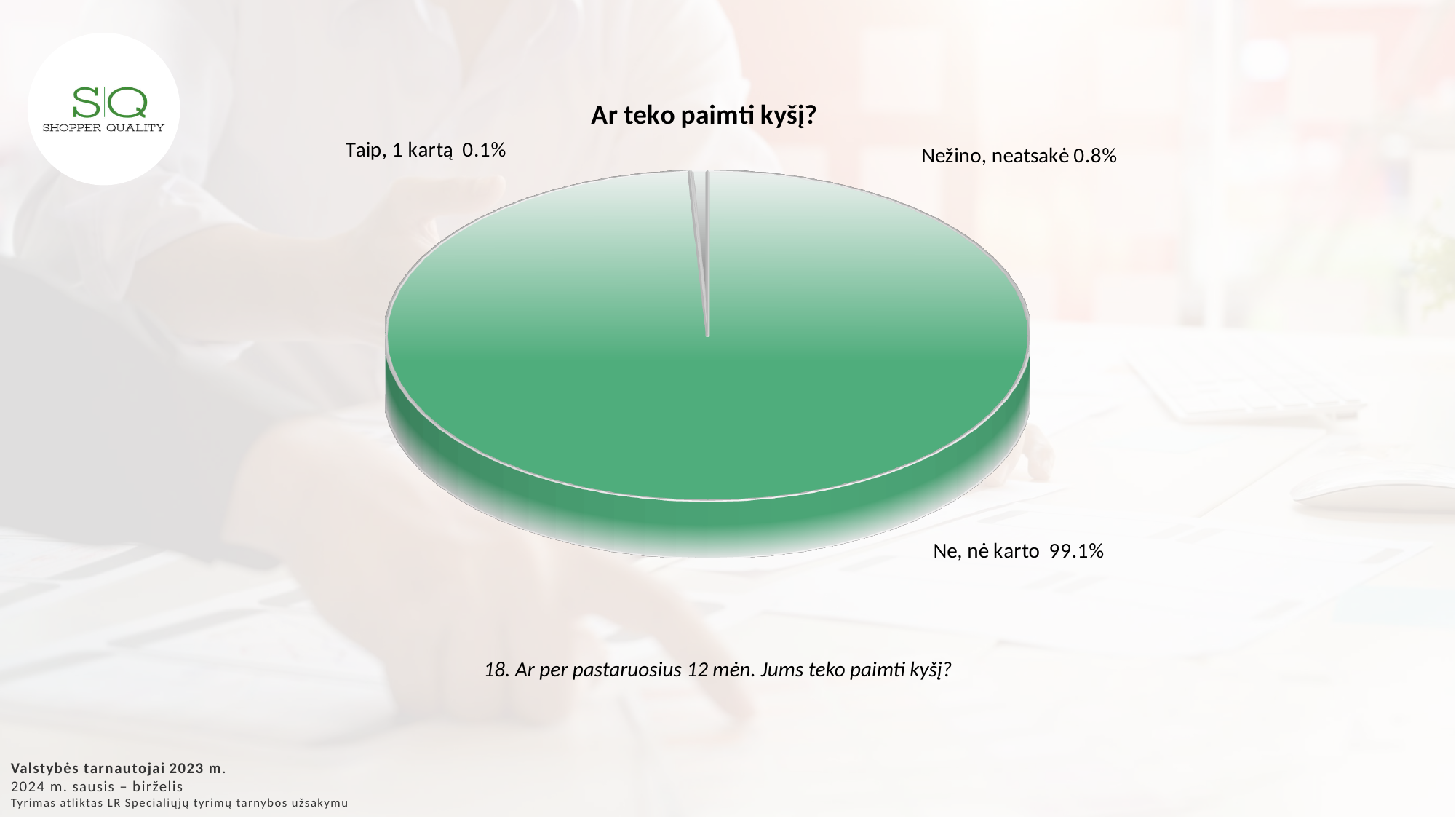
How many slices does the pie chart have? 3 Which slice of the pie is the largest? Ne, nė karto What is the difference between the share for "Ne, nė karto" and the share for "Nežino, neatsakė"? 98.3% Which slice of the pie is the smallest? Taip, 1 kartą What share of the pie is labelled "Nežino, neatsakė"? 0.8% What share of the pie is labelled "Taip, 1 kartą"? 0.1% What share of the pie is labelled "Ne, nė karto"? 99.1% Which is larger, the share for "Nežino, neatsakė" or the share for "Taip, 1 kartą"? Nežino, neatsakė What colour is the largest slice of the pie? green What is the difference between the share for "Nežino, neatsakė" and the share for "Taip, 1 kartą"? 0.7% What kind of chart is shown on the slide? pie chart What is the title of the chart? Ar teko paimti kyšį?